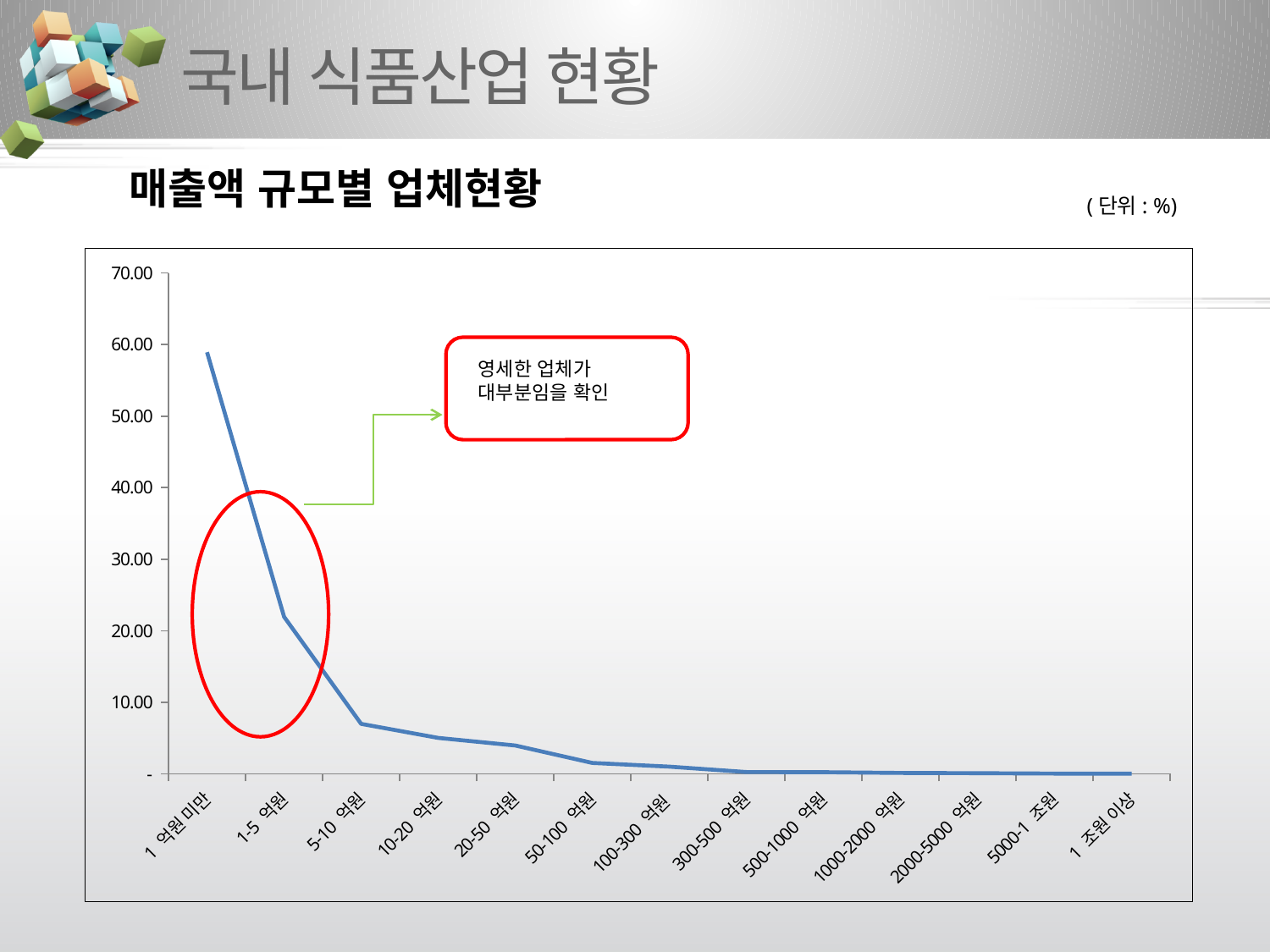
What kind of chart is shown on the slide? line chart Is the value for 5-10 억원 greater or less than 10? less What is the title of the chart on the slide? 매출액 규모별 업체현황 What unit is stated for the values in the chart? % Which category has the highest value in the chart? 1 억원 미만 Is the value for 10-20 억원 greater or less than 10? less Is the value for 1-5 억원 greater or less than 30? less Which is larger, the value for 1-5 억원 or the value for 5-10 억원? 1-5 억원 How many categories are shown along the x axis of the chart? 13 Do the values rise or fall as you move from left to right along the x axis? fall Which is larger, the value for 10-20 억원 or the value for 50-100 억원? 10-20 억원